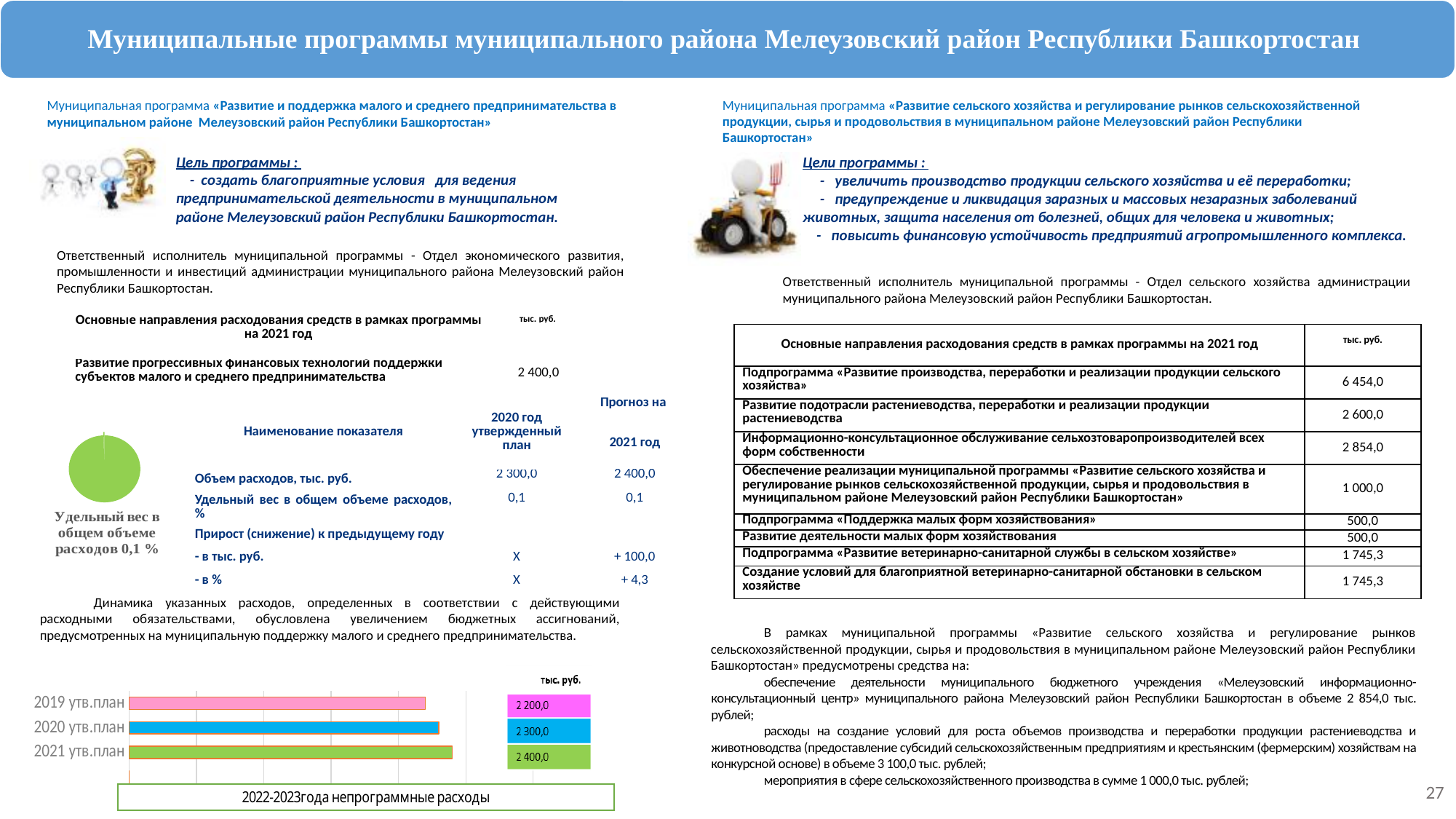
In the bar chart at the bottom left of the slide, which is larger: the value for 2020 утв.план or 2019 утв.план? 2020 утв.план In the bar chart at the bottom left of the slide, what is the value for 2019 утв.план? 2 200,0 In the bar chart at the bottom left of the slide, what is the value for 2020 утв.план? 2 300,0 In the bar chart at the bottom left of the slide, which category has the highest value? 2021 утв.план In the bar chart at the bottom left of the slide, what is the difference between the values for 2021 утв.план and 2019 утв.план? 200,0 How many categories are shown in the bar chart at the bottom left of the slide? 3 What kind of chart is shown at the bottom left of the slide? bar chart In the bar chart at the bottom left of the slide, what unit is indicated above the value labels? тыс. руб. In the bar chart at the bottom left of the slide, what is the value for 2021 утв.план? 2 400,0 What kind of chart is shown on the left side of the slide next to the text 'Удельный вес в общем объеме расходов 0,1 %'? pie chart In the bar chart at the bottom left of the slide, which category has the lowest value? 2019 утв.план In the bar chart at the bottom left of the slide, do the values rise or fall from 2019 утв.план to 2021 утв.план? rise